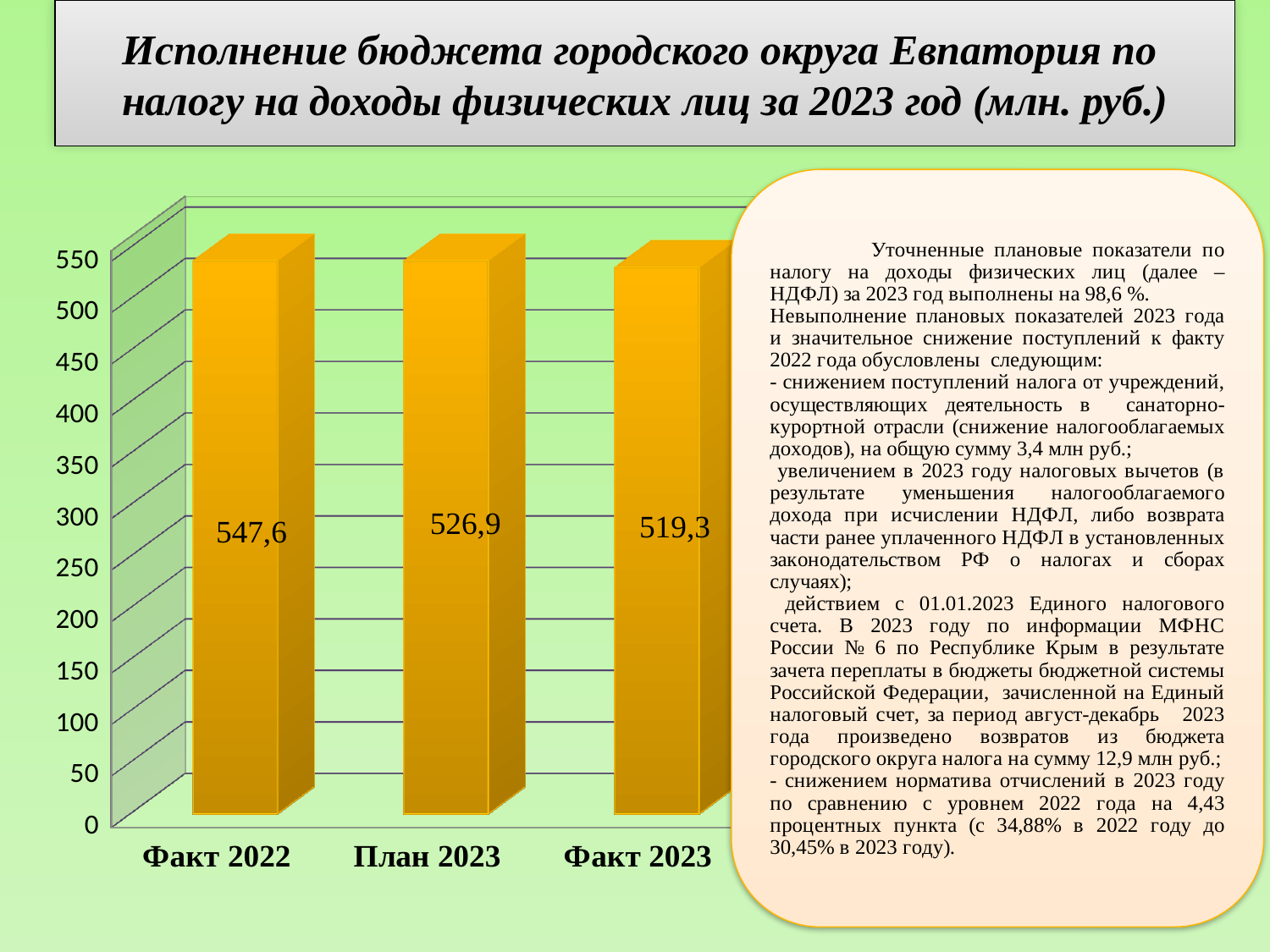
Which category has the lowest value? Факт 2023 What is the value for Факт 2023? 519,3 Is the value for Факт 2023 greater or less than 500? greater What is the difference between the values for План 2023 and Факт 2023? 7,6 What is the difference between the values for Факт 2022 and Факт 2023? 28,3 What is the value for План 2023? 526,9 Which category has the highest value? Факт 2022 Which is larger, the value for Факт 2022 or the value for План 2023? Факт 2022 What kind of chart is shown on the slide? bar chart Do the values rise or fall from Факт 2022 to Факт 2023? fall How many categories are shown on the chart? 3 What is the value for Факт 2022? 547,6